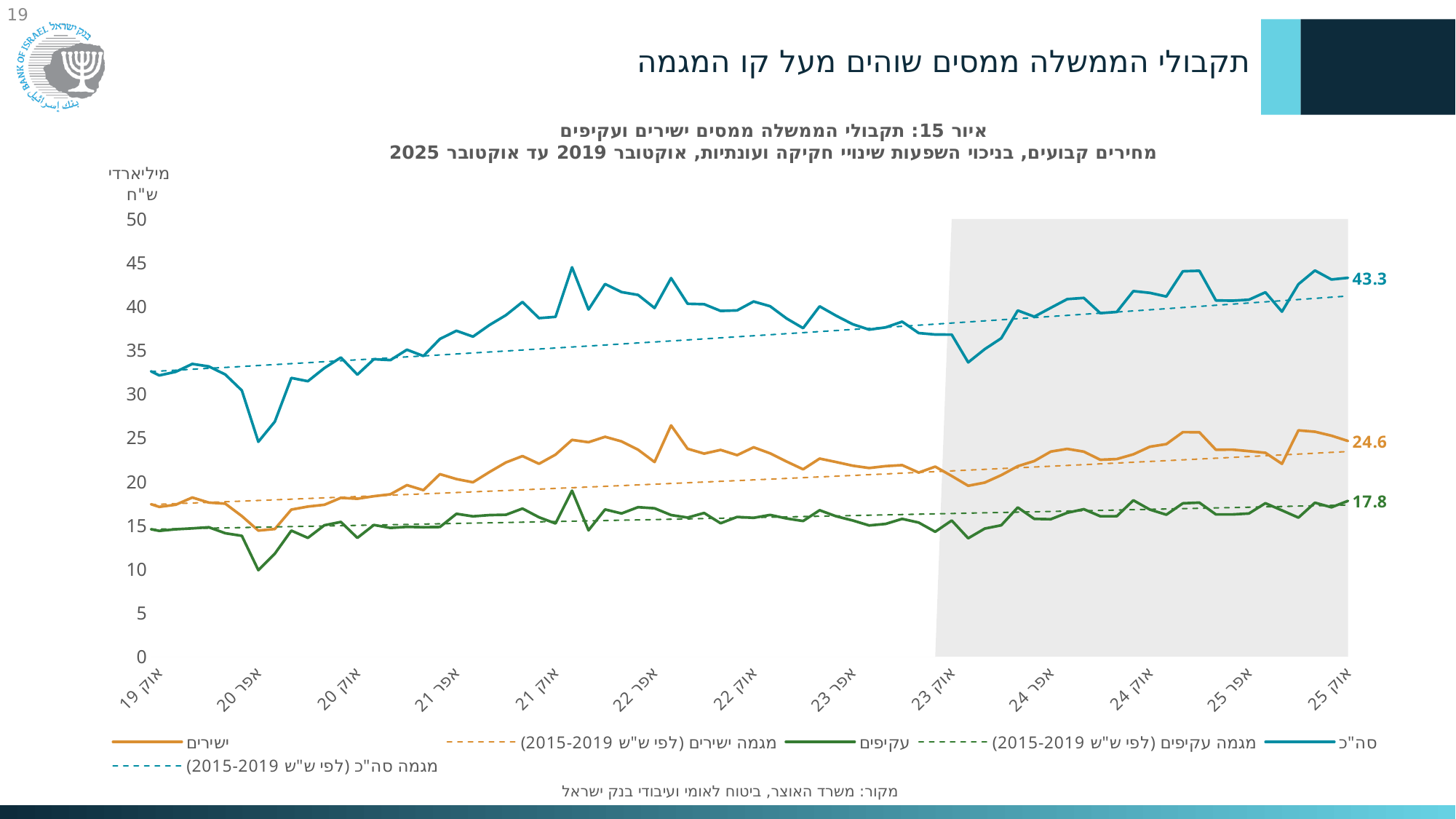
Which series has the lowest value at אוק 25: ישירים, עקיפים or סה"כ? עקיפים What is the value of the עקיפים (indirect taxes) series at the end of the chart (אוק 25)? 17.8 Does the סה"כ series overall rise or fall from אוק 19 to אוק 25? rise Is the value of the עקיפים series at its dip around אפר 20 greater or less than 15? less Is the value of the סה"כ series at its dip around אפר 20 greater or less than 30? less What kind of chart is shown on the slide? line chart What is the value of the ישירים (direct taxes) series at the end of the chart (אוק 25)? 24.6 What is the difference between the ישירים value (24.6) and the עקיפים value (17.8) at אוק 25? 6.8 Which series has the highest value at אוק 25: ישירים, עקיפים or סה"כ? סה"כ What is the difference between the סה"כ value (43.3) and the ישירים value (24.6) at אוק 25? 18.7 What is the value of the סה"כ (total) series at the end of the chart (אוק 25)? 43.3 How many entries does the chart legend list? 6